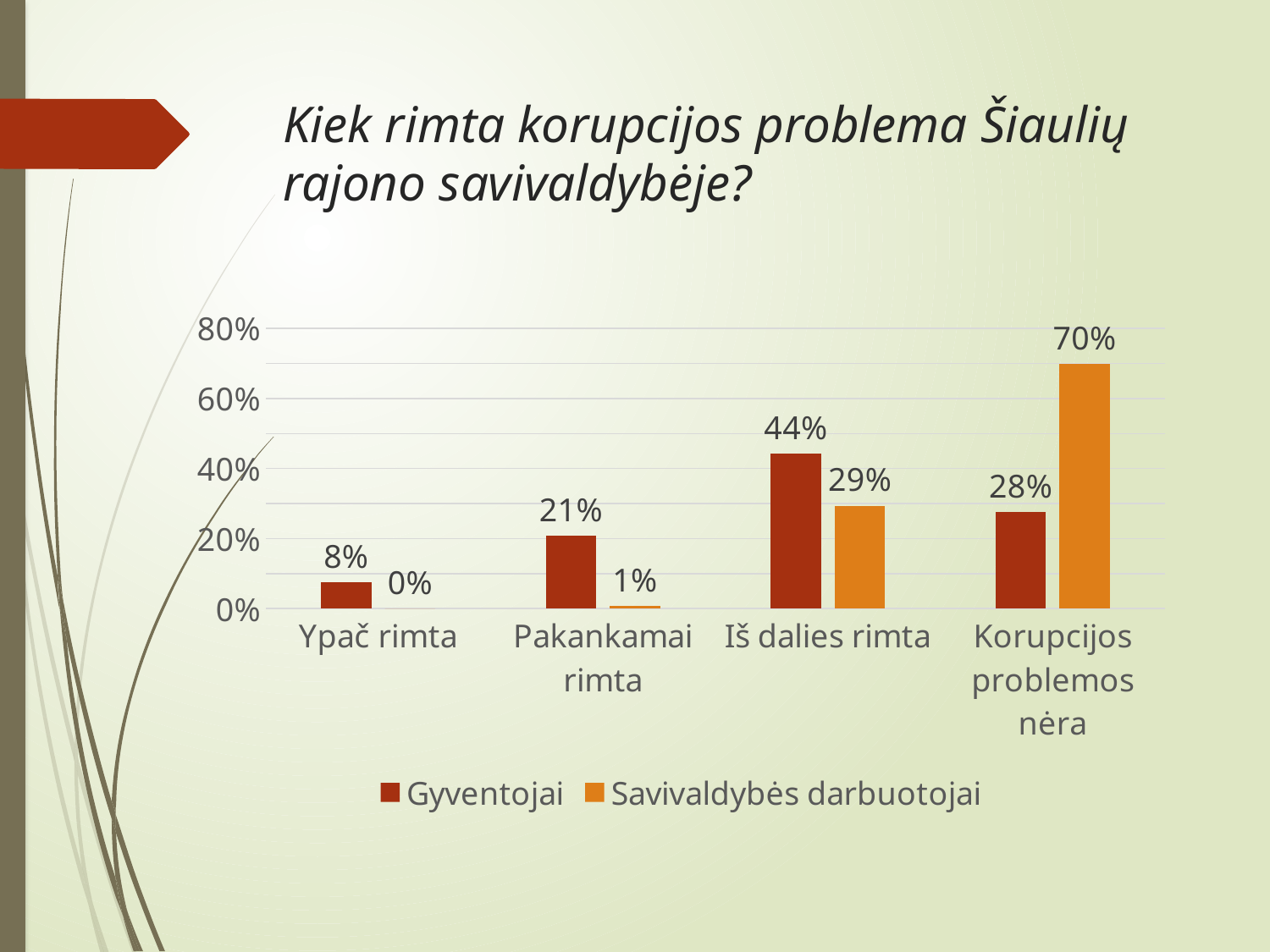
What is the value for Savivaldybės darbuotojai in the Korupcijos problemos nėra category? 70% Which series is shown in orange in the legend? Savivaldybės darbuotojai Which category has the lowest value for Savivaldybės darbuotojai? Ypač rimta Which category has the highest value for Gyventojai? Iš dalies rimta In the Iš dalies rimta category, which series has the larger value, Gyventojai or Savivaldybės darbuotojai? Gyventojai What is the value for Savivaldybės darbuotojai in the Pakankamai rimta category? 1% How many categories are shown on the x axis? 4 How many series does the legend list? 2 What is the value for Gyventojai in the Ypač rimta category? 8% What is the difference between the Savivaldybės darbuotojai and Gyventojai values in the Korupcijos problemos nėra category? 42% What kind of chart is shown on the slide? Bar chart Is the value for Savivaldybės darbuotojai in the Korupcijos problemos nėra category greater or less than 60%? greater